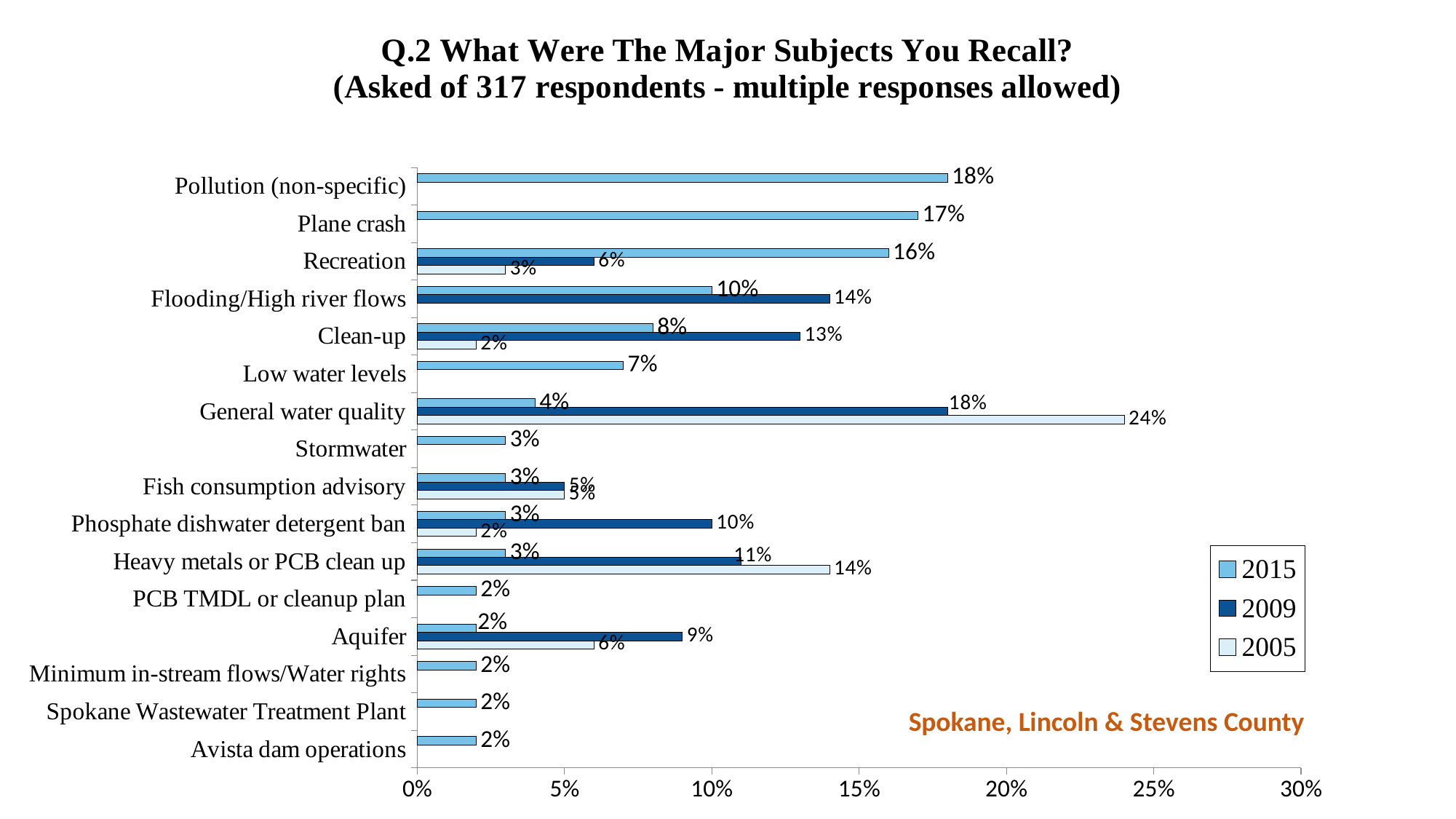
Which category has the highest 2015 value? Pollution (non-specific) What is the 2015 value for Pollution (non-specific)? 18% Which is larger for Clean-up: the 2015 value or the 2009 value? 2009 What is the 2009 value for Flooding/High river flows? 14% What is the 2005 value for General water quality? 24% Which category has the highest 2009 value? General water quality What is the difference between the 2009 and 2015 values for Aquifer? 7% What is the difference between the 2005 and 2015 values for General water quality? 20% How many categories are shown on the chart? 16 How many series does the legend list? 3 Which series is shown in the darkest blue in the legend? 2009 What type of chart is shown on the slide? Bar chart